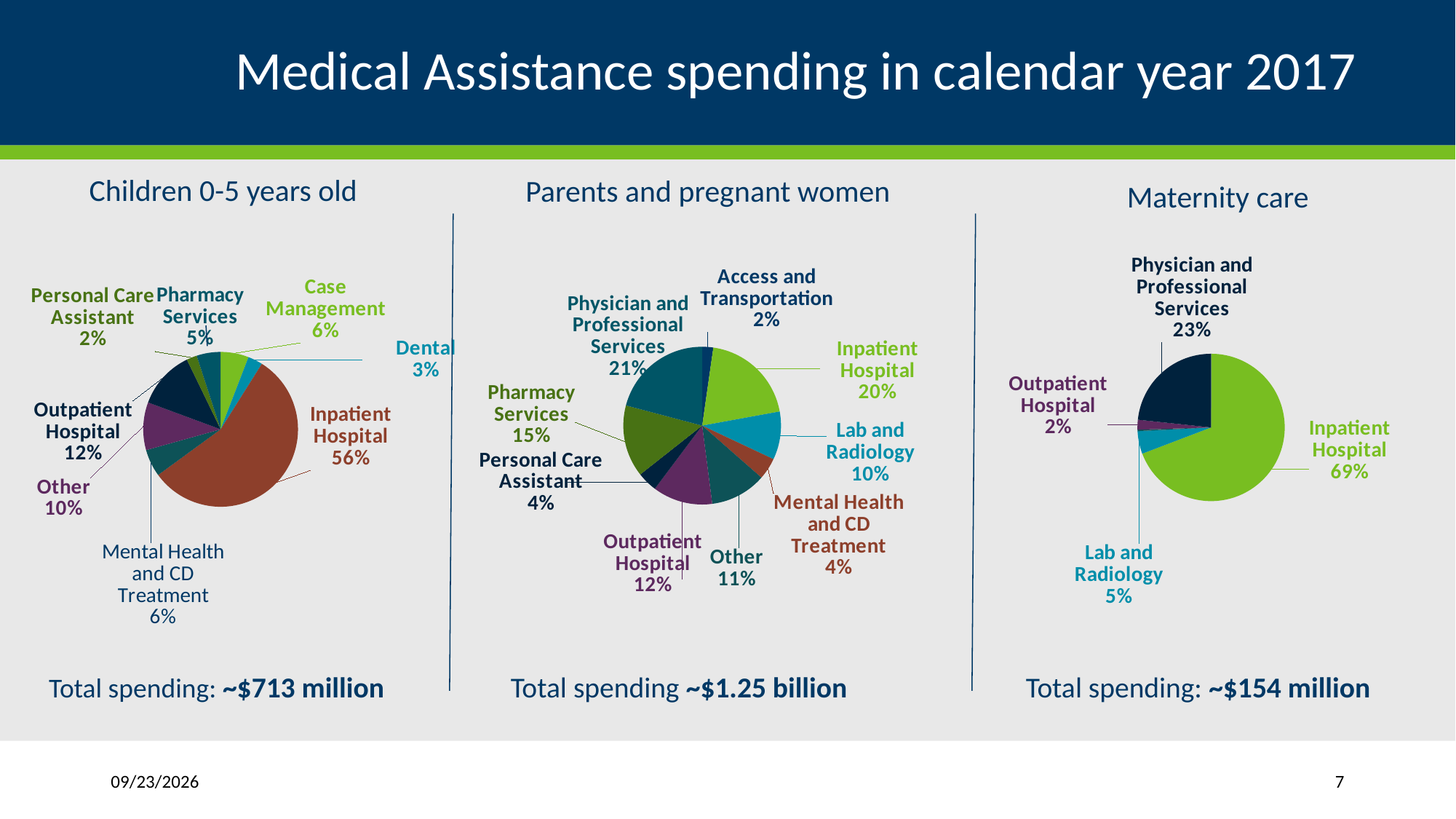
In the Parents and pregnant women chart, which is larger: Lab and Radiology or Other? Other How many categories are shown in the Parents and pregnant women pie chart? 9 In the Parents and pregnant women chart, which category has the largest share? Physician and Professional Services In the Children 0-5 years old chart, which category has the smallest share? Personal Care Assistant What total spending is shown below the Parents and pregnant women chart? ~$1.25 billion In the Maternity care chart, what is the difference between the Physician and Professional Services share and the Lab and Radiology share? 18% In the Children 0-5 years old chart, what share of spending is Inpatient Hospital? 56% In the Maternity care chart, what share of spending is Inpatient Hospital? 69% What kind of chart is used for Maternity care? Pie chart How many categories are shown in the Children 0-5 years old pie chart? 8 In the Parents and pregnant women chart, what share of spending is Pharmacy Services? 15% In the Children 0-5 years old chart, what is the difference between the Outpatient Hospital share and the Other share? 2%